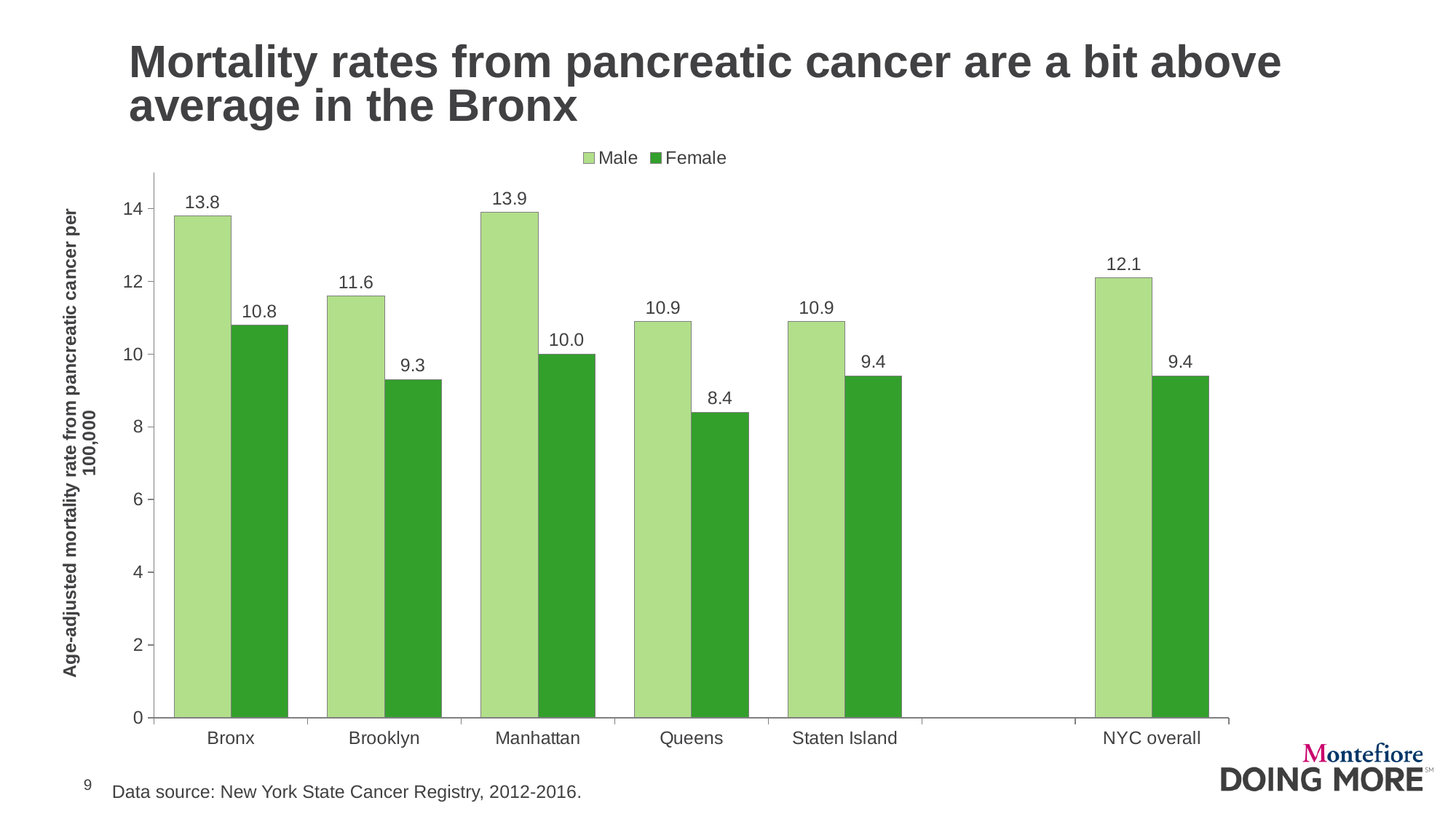
What kind of chart is shown on the slide? bar chart Which category has the highest Male mortality rate? Manhattan What is the difference between the Male and Female mortality rates in the Bronx? 3.0 What is the data source cited on the slide? New York State Cancer Registry, 2012-2016 Which category has the lowest Female mortality rate? Queens What is the Male mortality rate for NYC overall? 12.1 How many series does the legend list? 2 Is the Male mortality rate for Brooklyn greater or less than 10? greater How many categories are shown on the x axis? 6 What is the Male mortality rate for the Bronx? 13.8 What is the Female mortality rate for Queens? 8.4 Which is larger, the Female rate for Brooklyn or the Female rate for Manhattan? Manhattan